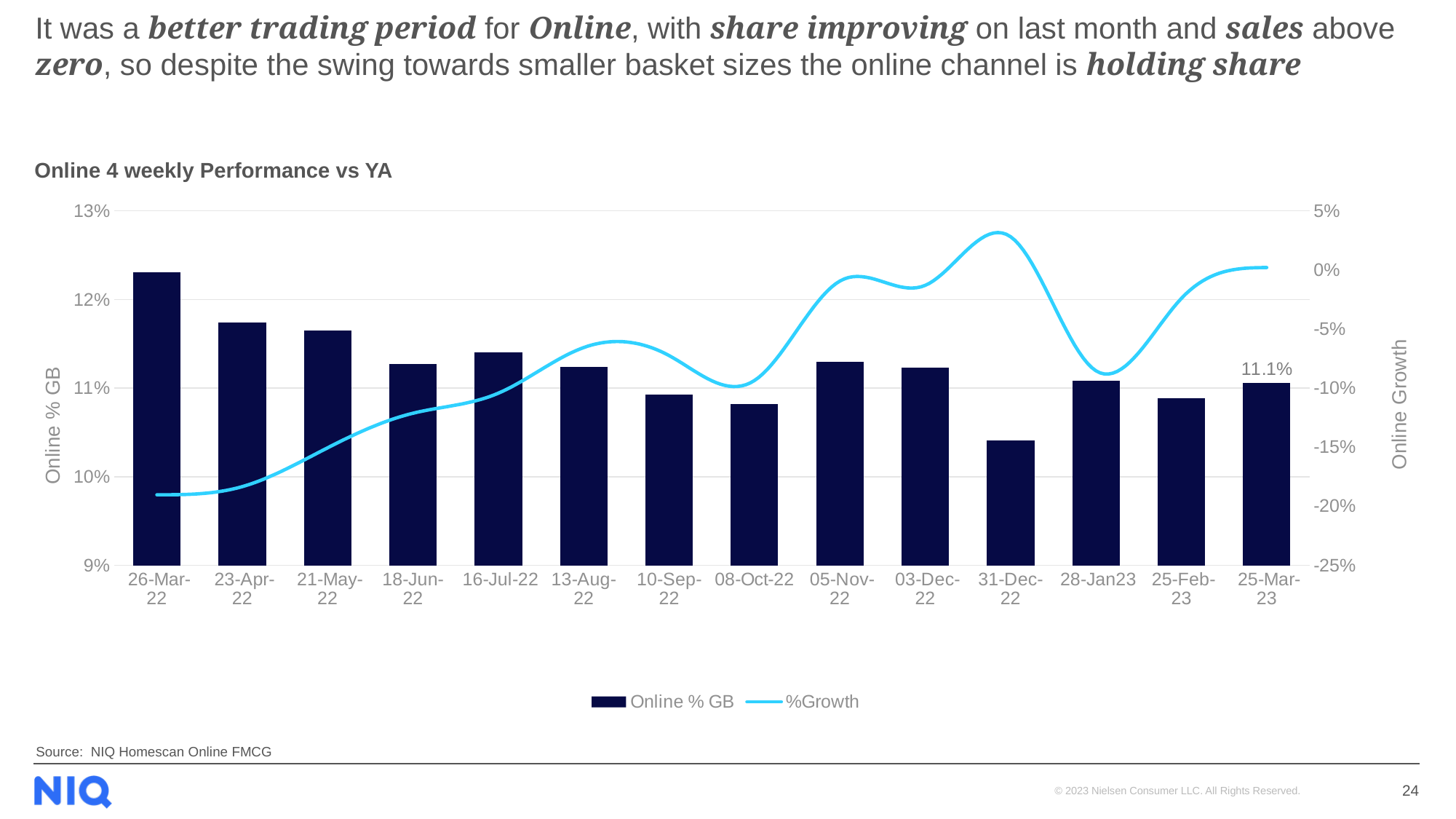
Which period has the lowest Online % GB bar? 31-Dec-22 Is the Online % GB value for 26-Mar-22 greater or less than 12%? greater At which period does the %Growth line reach its highest point? 31-Dec-22 Which period has the highest Online % GB bar? 26-Mar-22 What is the Online % GB value for 25-Mar-23? 11.1% Is the %Growth value for 28-Jan23 greater or less than -5%? less Does the %Growth line rise or fall from 26-Mar-22 to 13-Aug-22? rise How many series does the legend list? 2 Which is larger, the Online % GB bar for 05-Nov-22 or for 31-Dec-22? 05-Nov-22 How many periods are shown on the x axis? 14 Is the Online % GB value for 31-Dec-22 greater or less than 11%? less What kind of chart is this? A bar chart combined with a line chart